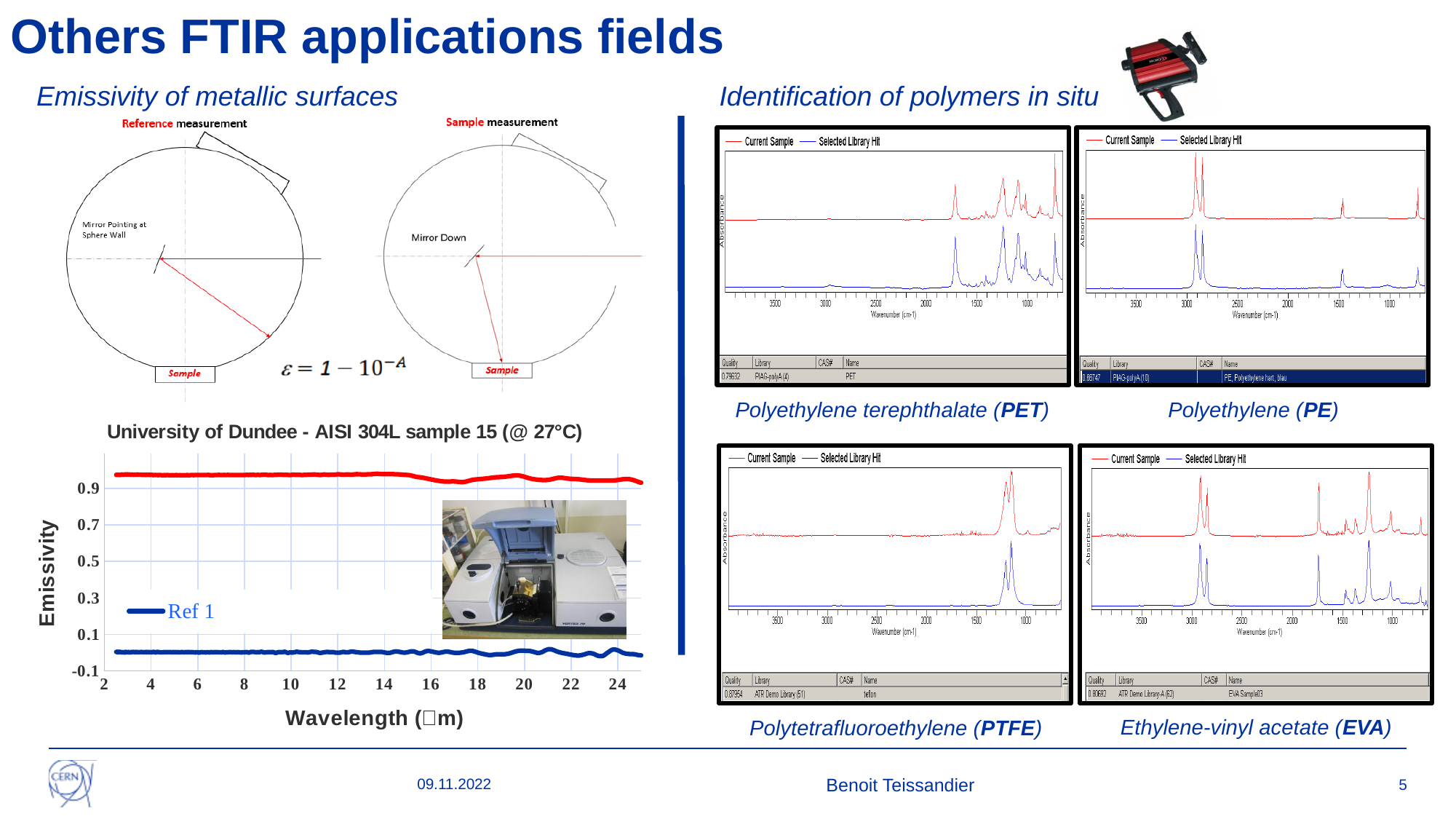
In the emissivity chart, is the value of the Ref 1 series at wavelength 10 greater or less than 0.1? less In the emissivity chart, is the value of the red series at wavelength 10 greater or less than 0.9? greater What is the title of the emissivity chart on the left of the slide? University of Dundee - AISI 304L sample 15 (@ 27°C) In the emissivity chart, what is the name of the series shown in the legend? Ref 1 In the emissivity chart, how many entries does the legend list? 1 In the emissivity chart, does the red series rise or fall overall as wavelength increases from 2 to 24? fall Which polymer is identified in the bottom-right FTIR spectrum panel? Ethylene-vinyl acetate (EVA) How many FTIR spectrum panels are shown under 'Identification of polymers in situ'? 4 What kind of chart is the 'University of Dundee - AISI 304L sample 15 (@ 27°C)' chart? line chart In the emissivity chart, what is the highest tick value shown on the y axis? 0.9 In the emissivity chart, what is the lowest tick value shown on the x axis? 2 In the emissivity chart, which series has the larger value at wavelength 12, the red series or Ref 1? the red series